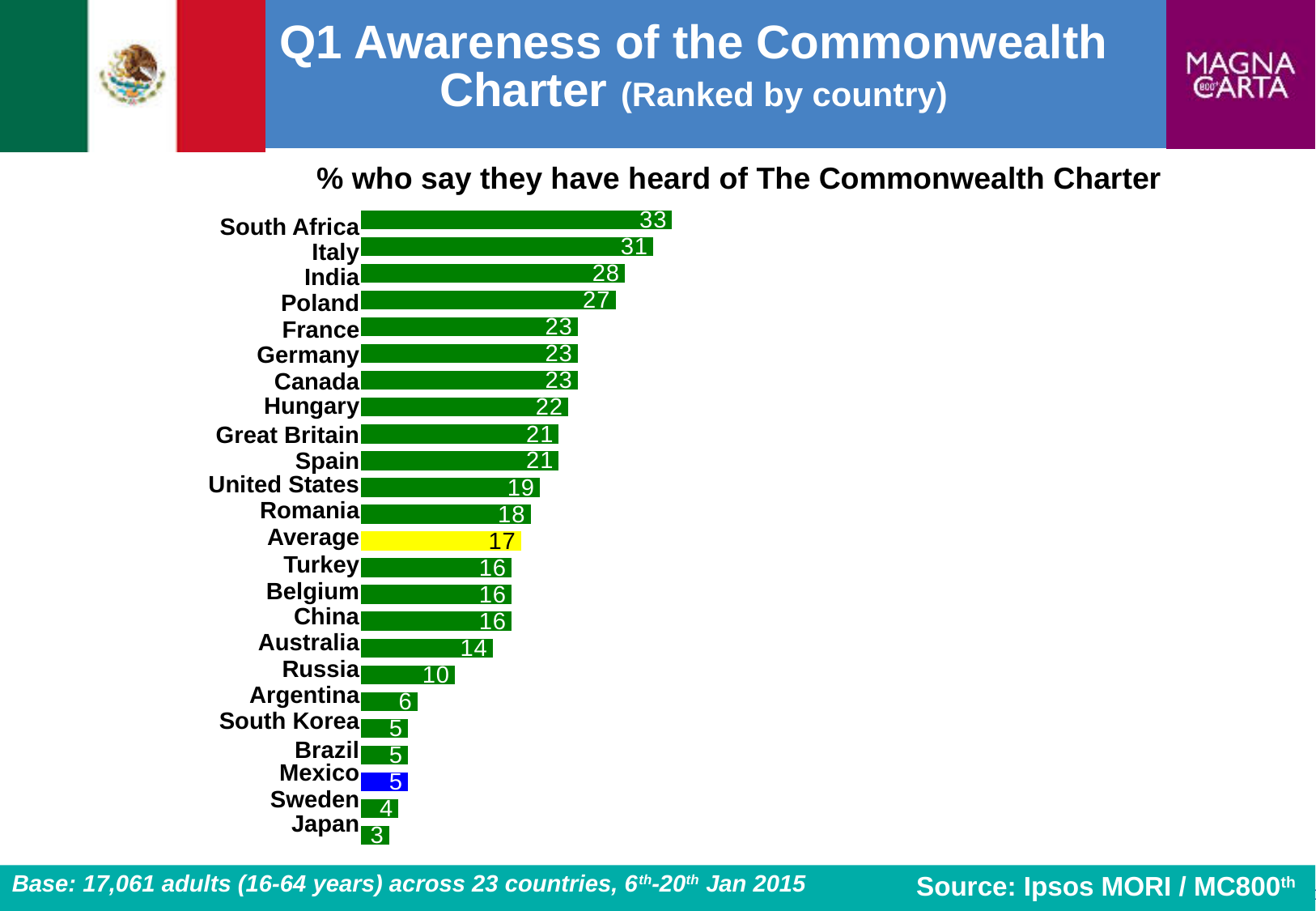
What is the value for South Africa? 33 What is the value for Mexico? 5 How many bars are plotted on the chart, including Average? 24 Which bar is coloured blue? Mexico What is the value for Russia? 10 What is the value shown for Average? 17 Which country has the highest value? South Africa Which country has the lowest value? Japan What is the difference between the values for Poland and Australia? 13 What kind of chart is shown on the slide? Bar chart Which has a larger value, Hungary or Romania? Hungary What is the difference between the values for Italy and India? 3